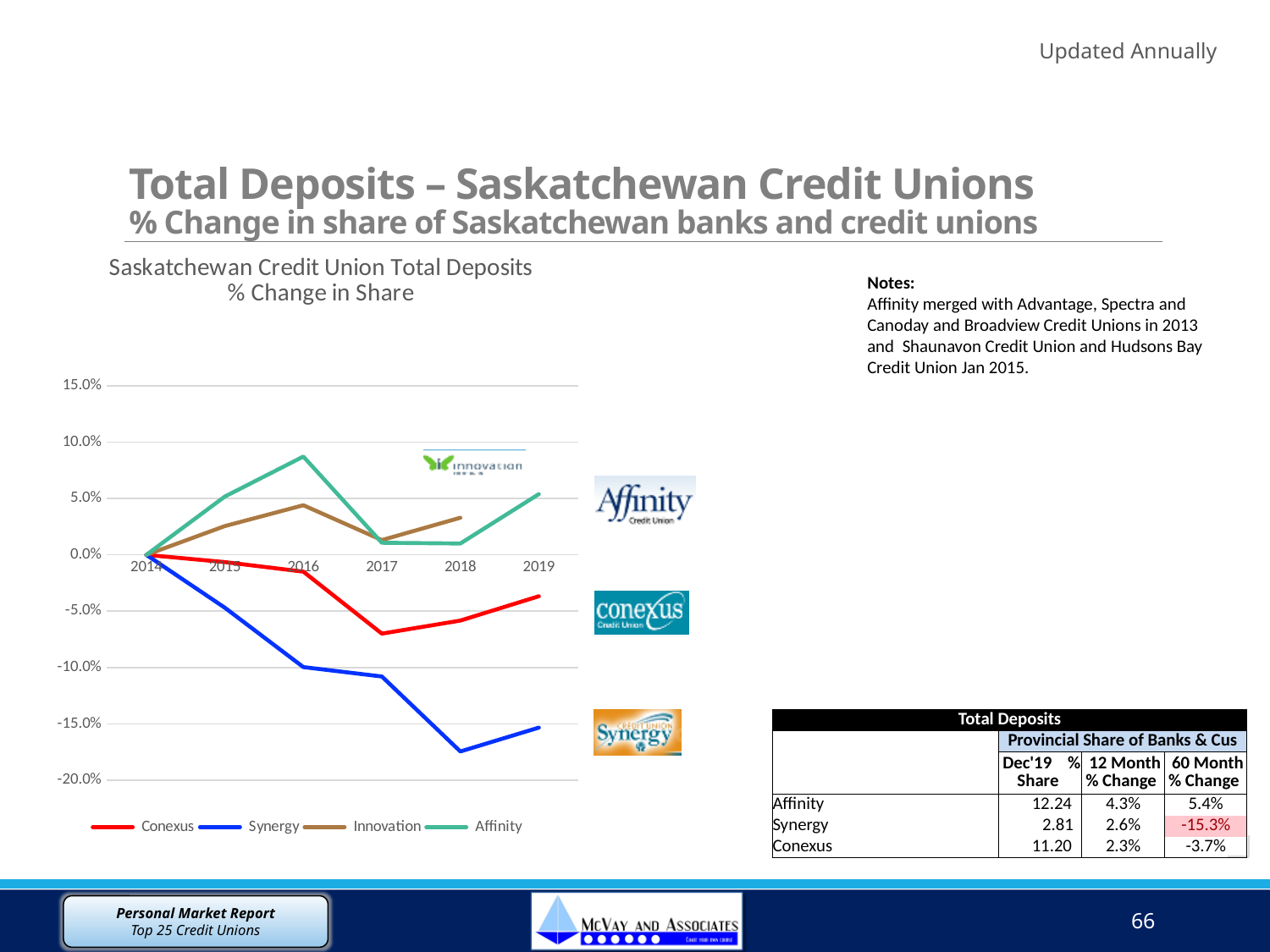
Is the value for Affinity in 2016 greater or less than 5.0%? greater In 2017, which is larger: the value for Conexus or the value for Synergy? Conexus What is the title of the chart? Saskatchewan Credit Union Total Deposits % Change in Share What colour is the Synergy line in the chart? blue Which credit union has the highest % change in share in 2016? Affinity Is the value for Conexus in 2017 greater or less than -5.0%? less Is the value for Synergy in 2018 greater or less than -15.0%? less Which credit union has the lowest % change in share in 2018? Synergy What kind of chart is shown on the slide? line chart Does the Synergy line rise or fall from 2014 to 2018? fall How many years are shown along the x axis of the chart? 6 How many series does the chart legend list? 4